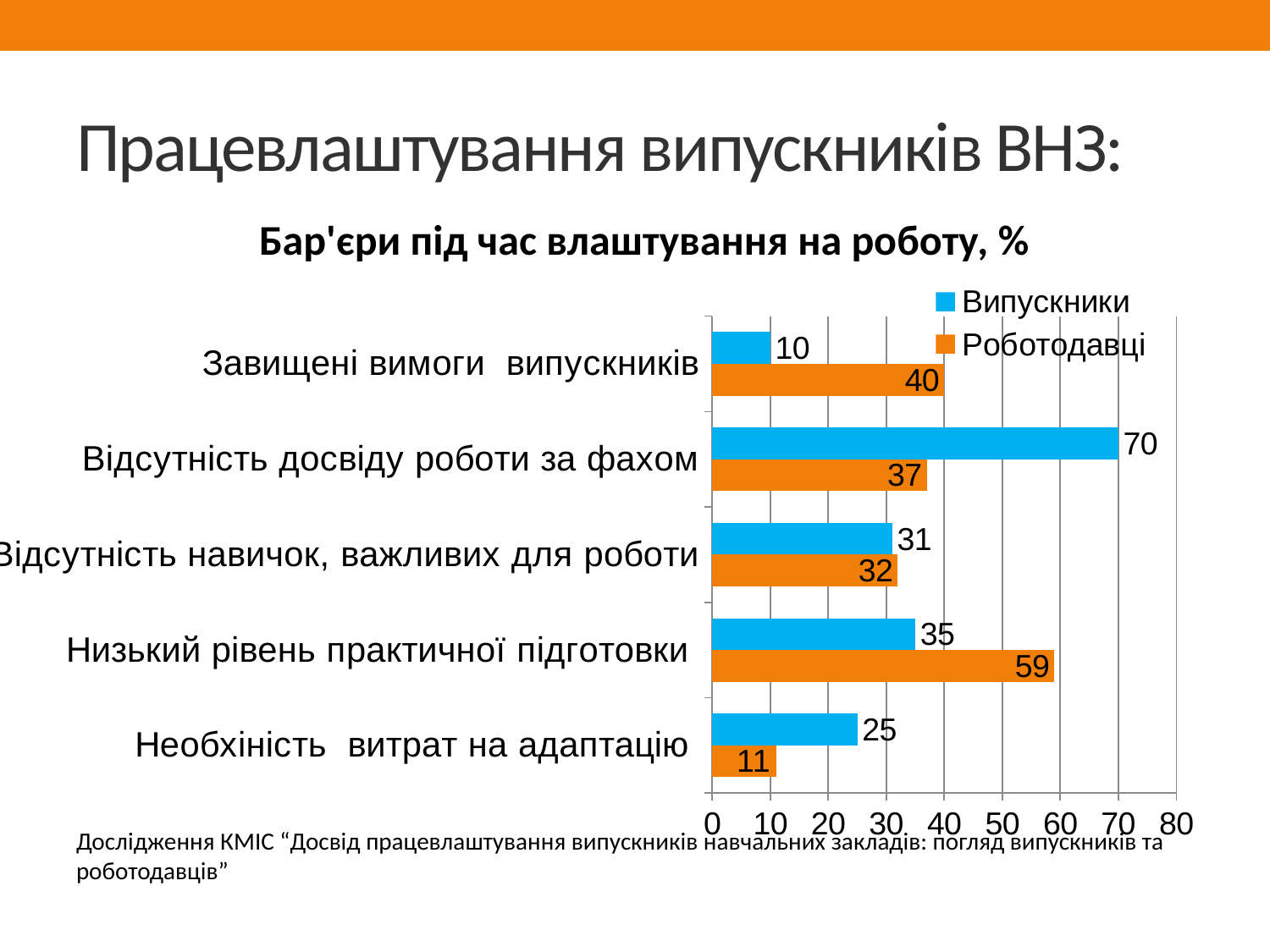
What is the value for Роботодавці for 'Низький рівень практичної підготовки'? 59 How many categories are shown in the chart? 5 Which category has the lowest value for Роботодавці? Необхіність витрат на адаптацію What is the value for Роботодавці for 'Завищені вимоги випускників'? 40 What type of chart is shown on the slide? Bar chart For 'Низький рівень практичної підготовки', which series has the larger value, Випускники or Роботодавці? Роботодавці What is the title of the chart? Бар'єри під час влаштування на роботу, % What is the value for Випускники for 'Необхіність витрат на адаптацію'? 25 What is the value for Випускники for 'Відсутність досвіду роботи за фахом'? 70 What is the difference between the Роботодавці and Випускники values for 'Завищені вимоги випускників'? 30 How many series does the legend list? 2 Which category has the highest value for Випускники? Відсутність досвіду роботи за фахом